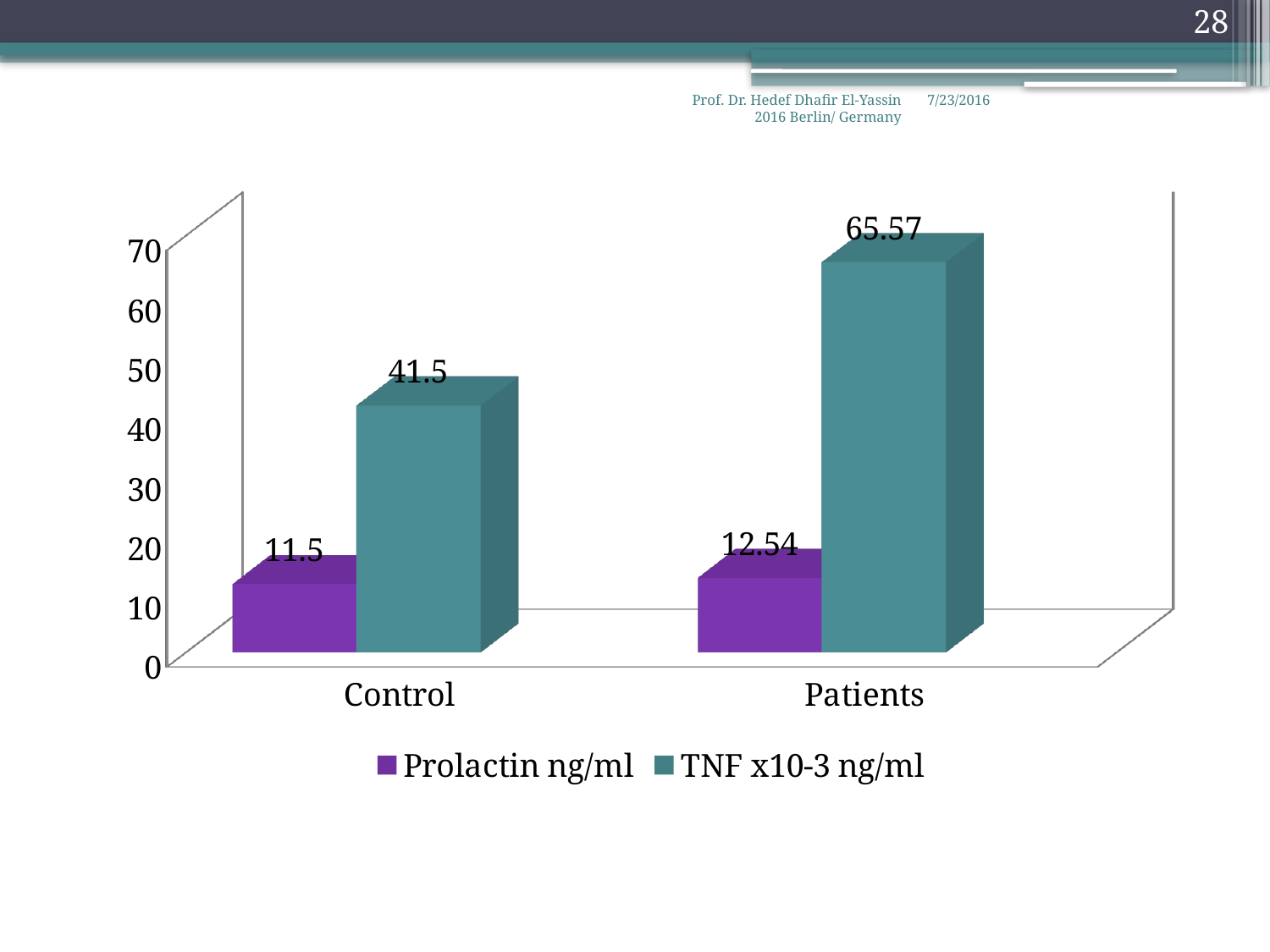
What is the difference between the TNF x10-3 ng/ml values for Patients and Control? 24.07 What is the TNF x10-3 ng/ml value for Patients? 65.57 Which category has the lowest Prolactin ng/ml value? Control What colour are the Prolactin ng/ml bars? Purple How many series does the legend list? 2 Which is larger: the Prolactin ng/ml value for Patients or for Control? Patients What is the Prolactin ng/ml value for Control? 11.5 What is the TNF x10-3 ng/ml value for Control? 41.5 What kind of chart is shown on the slide? Bar chart How many categories are shown on the x axis? 2 What is the Prolactin ng/ml value for Patients? 12.54 Which category has the highest TNF x10-3 ng/ml value? Patients